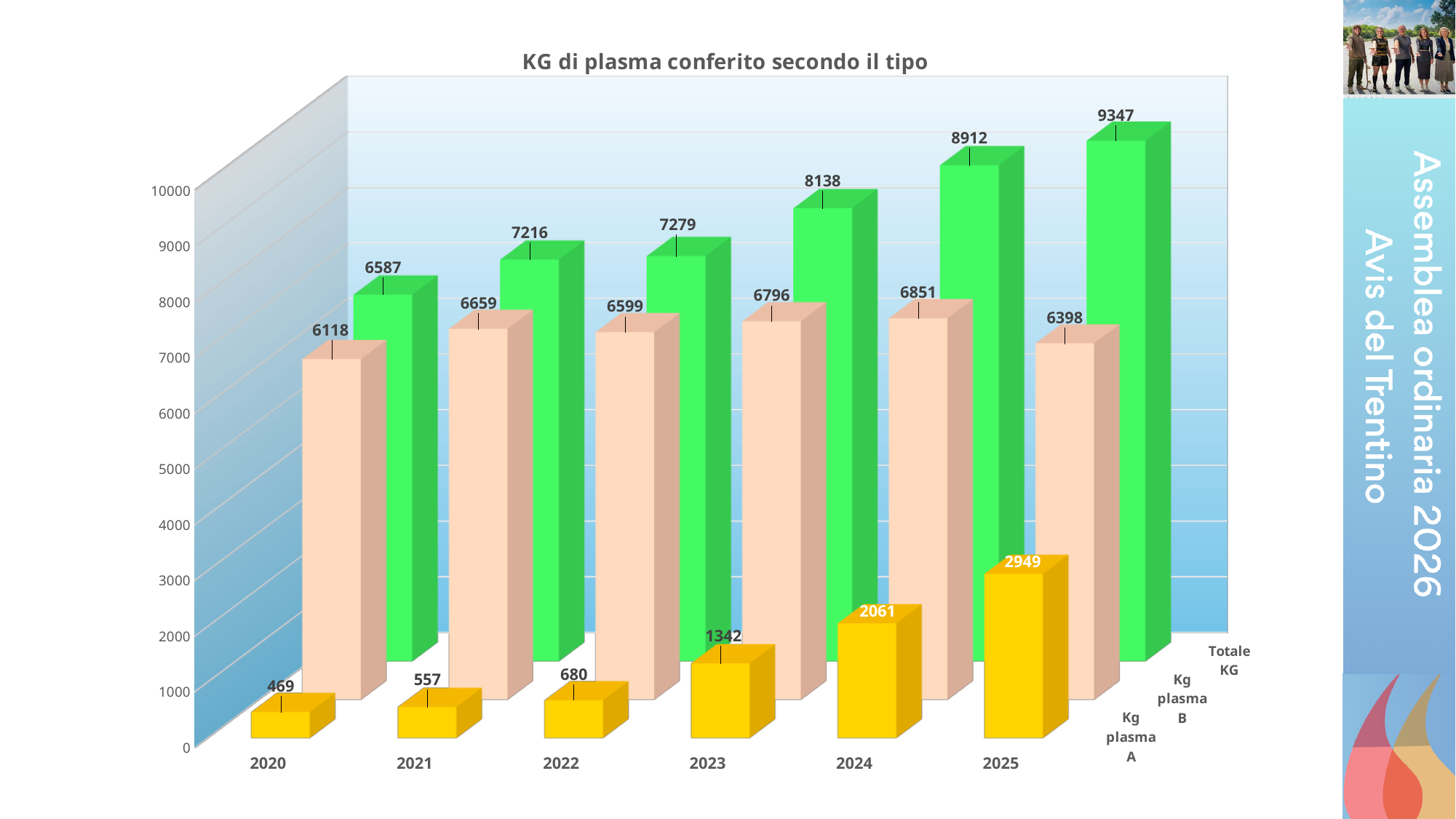
How many series does the chart show? 3 In which year is Totale KG highest? 2025 What is the title of the chart? KG di plasma conferito secondo il tipo What is the value of Kg plasma A in 2025? 2949 How many years are shown on the x axis? 6 What is the value of Kg plasma B in 2021? 6659 Which is larger: Kg plasma B in 2024 or Kg plasma B in 2025? Kg plasma B in 2024 What is the Totale KG value for 2023? 8138 Does Totale KG rise or fall from 2020 to 2025? rise What type of chart is shown on the slide? bar chart In which year is Kg plasma A lowest? 2020 What is the difference between Totale KG in 2025 and Totale KG in 2020? 2760